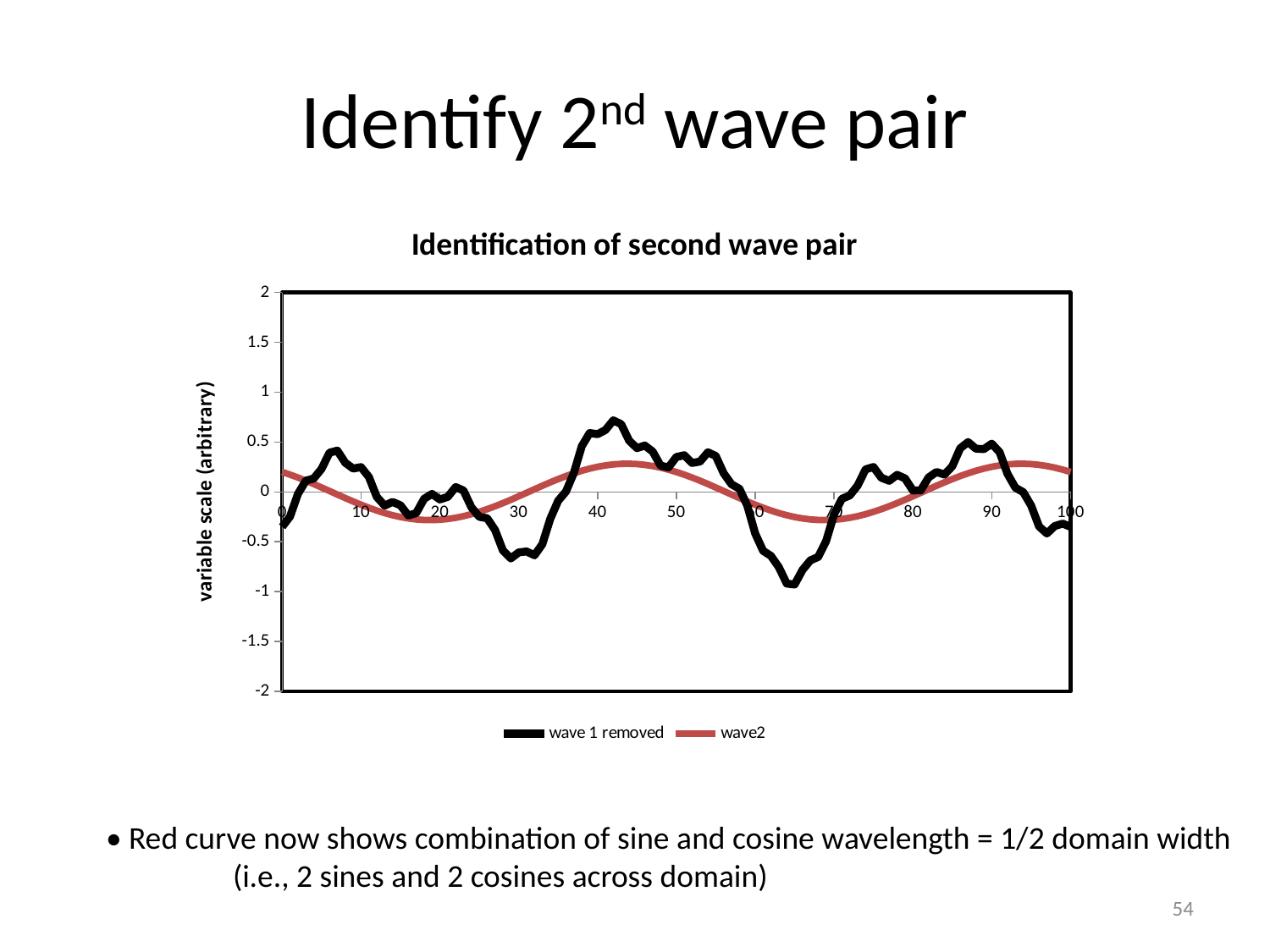
Which series reaches the higher maximum value, 'wave 1 removed' or 'wave2'? wave 1 removed What kind of chart is shown on the slide? line chart Is the value of the 'wave 1 removed' series at x = 65 greater or less than -0.5? less What is the title of the chart? Identification of second wave pair Is the value of the 'wave2' series at x = 70 greater or less than 0? less Is the value of the 'wave2' series at x = 45 greater or less than 0? greater Which series is drawn in red? wave2 How many series does the legend list? 2 How many labelled tick marks are on the x axis? 11 Which series reaches the lower minimum value, 'wave 1 removed' or 'wave2'? wave 1 removed